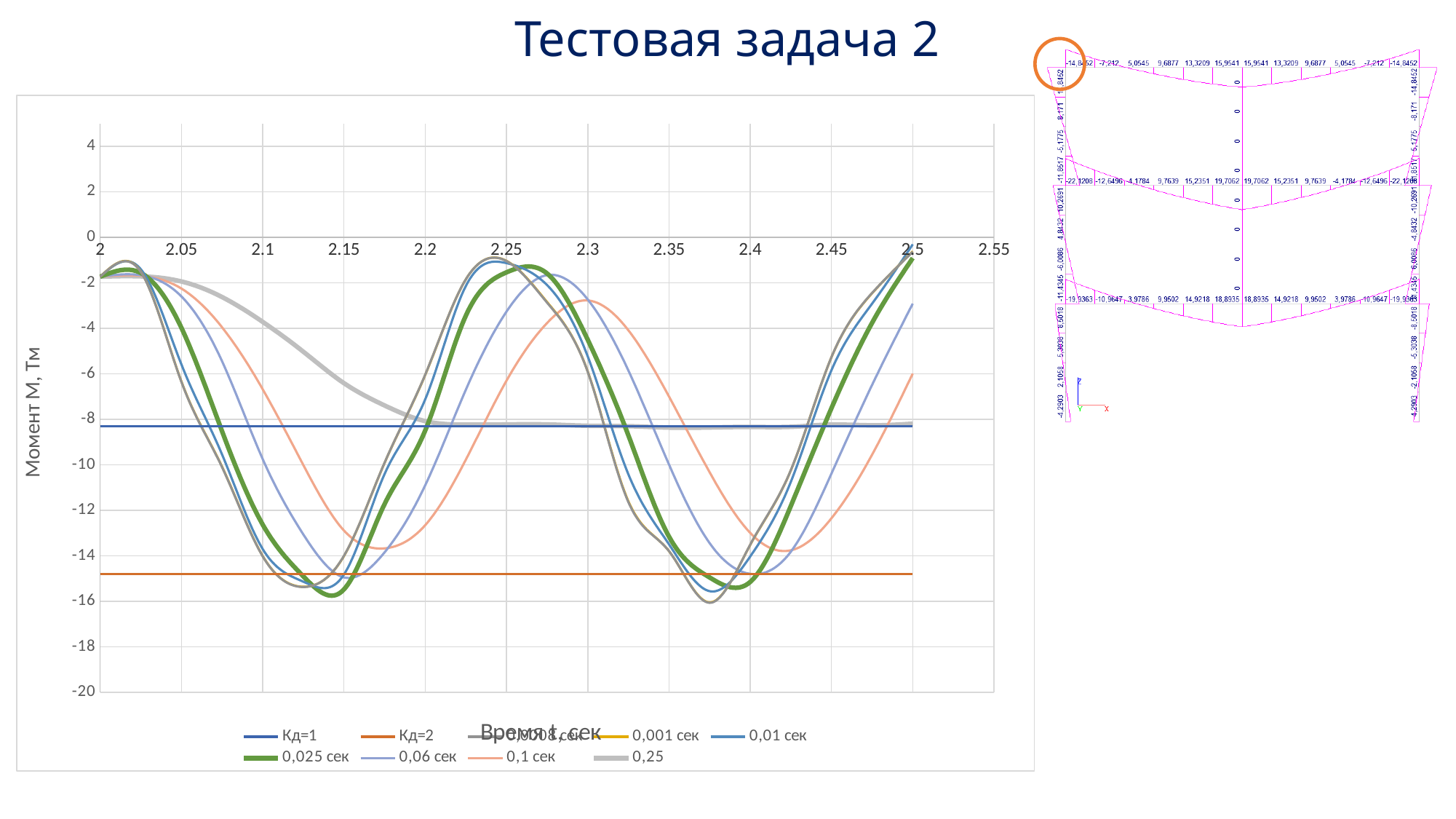
How many series does the legend of the line chart list? 9 What is the title of the vertical axis of the line chart? Момент М, Тм Is the lowest point of the 0,025 сек series greater or less than -14? less What is the title of the horizontal axis of the line chart? Время t, сек Is the lowest point of the 0,1 сек series greater or less than -12? less Is the value of the Кд=2 line greater or less than -14? less Does the 0,25 series rise or fall between t = 2.05 and t = 2.2? fall What is the lowest value shown on the vertical axis of the line chart? -20 Which of the two horizontal lines, Кд=1 or Кд=2, lies at a higher value on the line chart? Кд=1 What kind of chart is shown on the left of the slide? line chart